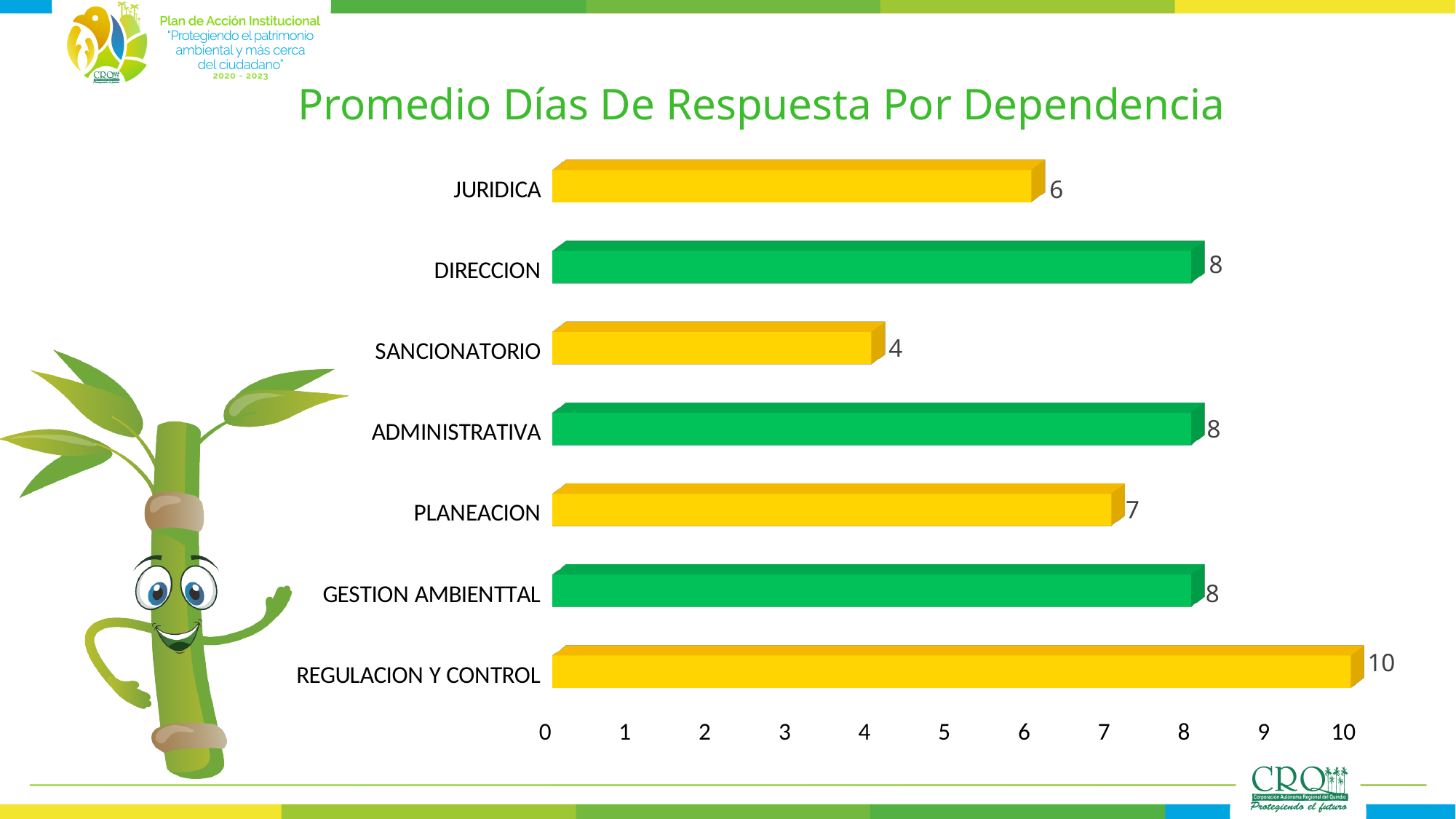
What is the value for REGULACION Y CONTROL? 10 What is the difference between the values for REGULACION Y CONTROL and SANCIONATORIO? 6 What is the difference between the values for DIRECCION and JURIDICA? 2 What is the value for SANCIONATORIO? 4 Which category has the highest value? REGULACION Y CONTROL How many categories are shown in the chart? 7 What is the value for JURIDICA? 6 Which is larger, the value for PLANEACION or the value for JURIDICA? PLANEACION Which category has the lowest value? SANCIONATORIO What is the title of the chart? Promedio Días De Respuesta Por Dependencia What is the value for PLANEACION? 7 What kind of chart is shown on the slide? Bar chart